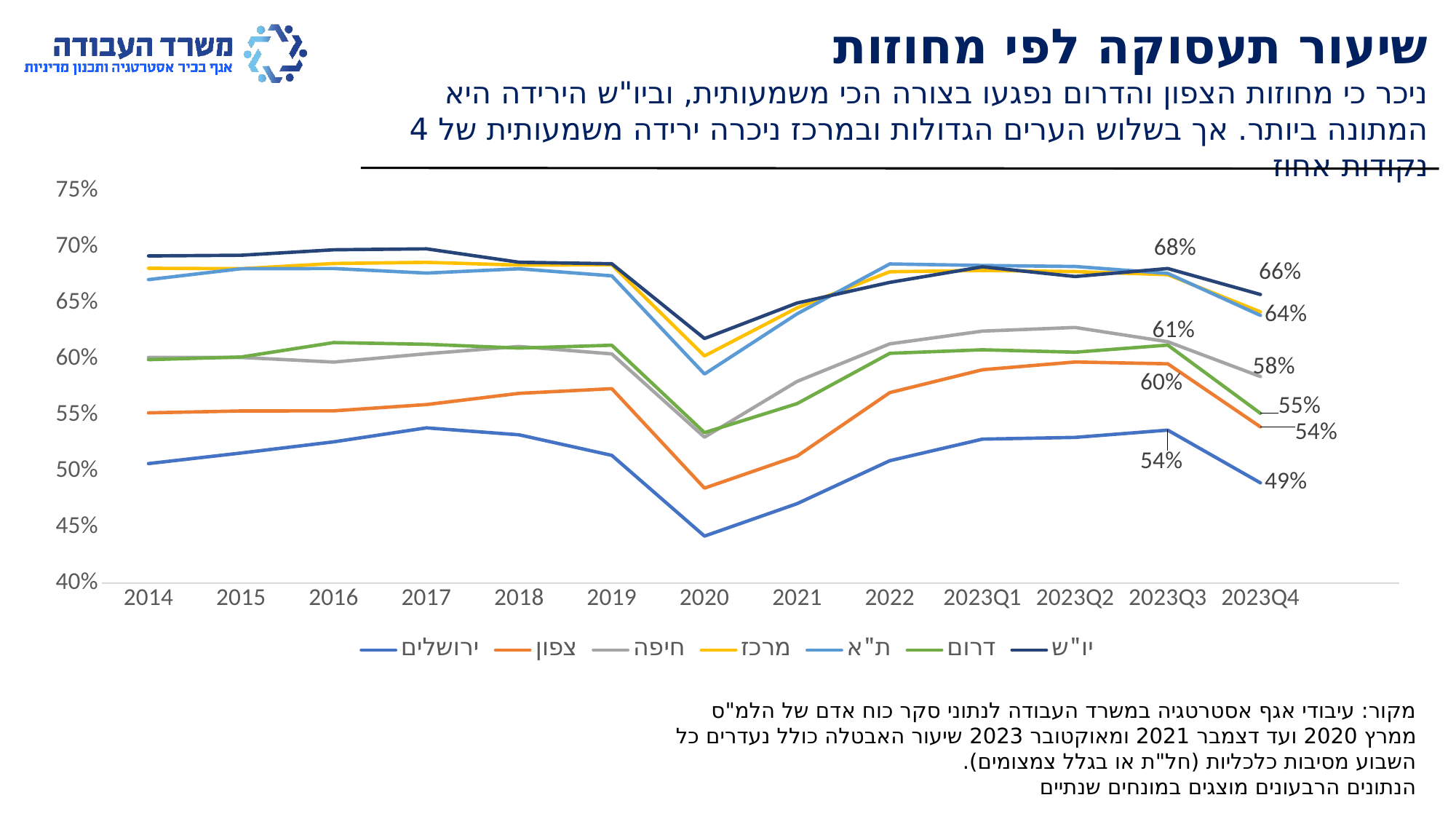
What is the value for דרום in 2023Q3? 61% What is the value for חיפה in 2023Q4? 58% What kind of chart is shown on the slide? line chart What is the value for ירושלים in 2023Q4? 49% By how many percentage points did ירושלים fall from 2023Q3 to 2023Q4? 5 percentage points Which series has the highest value in 2023Q4? יו"ש What is the value for יו"ש in 2023Q4? 66% Is the value for ירושלים in 2020 greater or less than 50%? less How many series does the legend list? 7 How many time points are shown along the x axis? 13 Which series has the lowest value in 2023Q4? ירושלים What is the value for יו"ש in 2023Q3? 68%